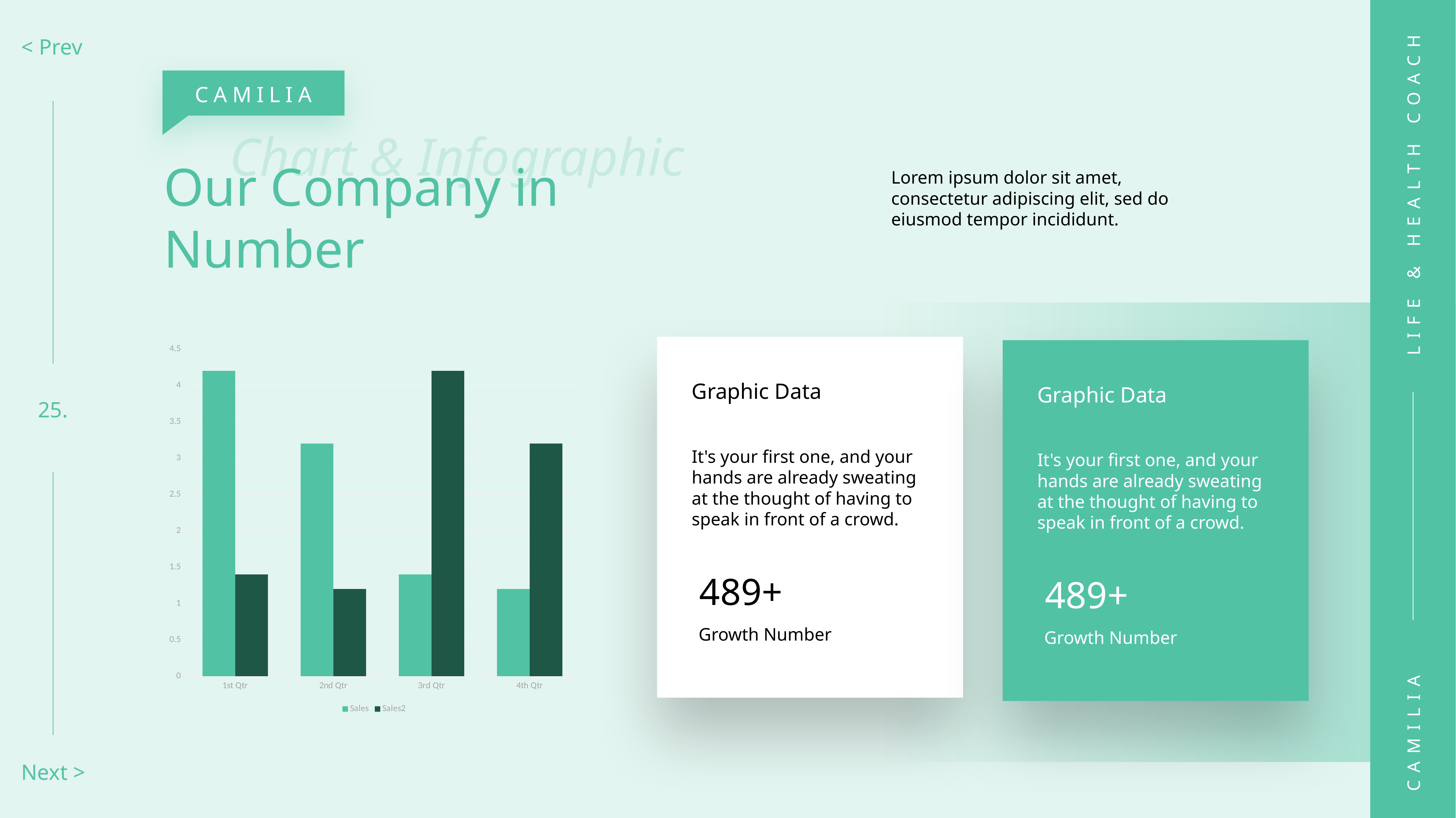
Which quarter has the highest value for the Sales series? 1st Qtr What are the names of the two series in the chart legend? Sales and Sales2 Is the Sales value for 2nd Qtr greater or less than 3? greater Which is larger in 3rd Qtr, the Sales value or the Sales2 value? Sales2 Is the Sales value for 1st Qtr greater or less than 4? greater How many series does the chart legend list? 2 Is the Sales2 value for 4th Qtr greater or less than 3.5? less Which quarter has the highest value for the Sales2 series? 3rd Qtr Do the Sales values rise or fall from 1st Qtr to 4th Qtr? fall How many categories are shown on the x axis of the chart? 4 What kind of chart is shown on the slide? bar chart